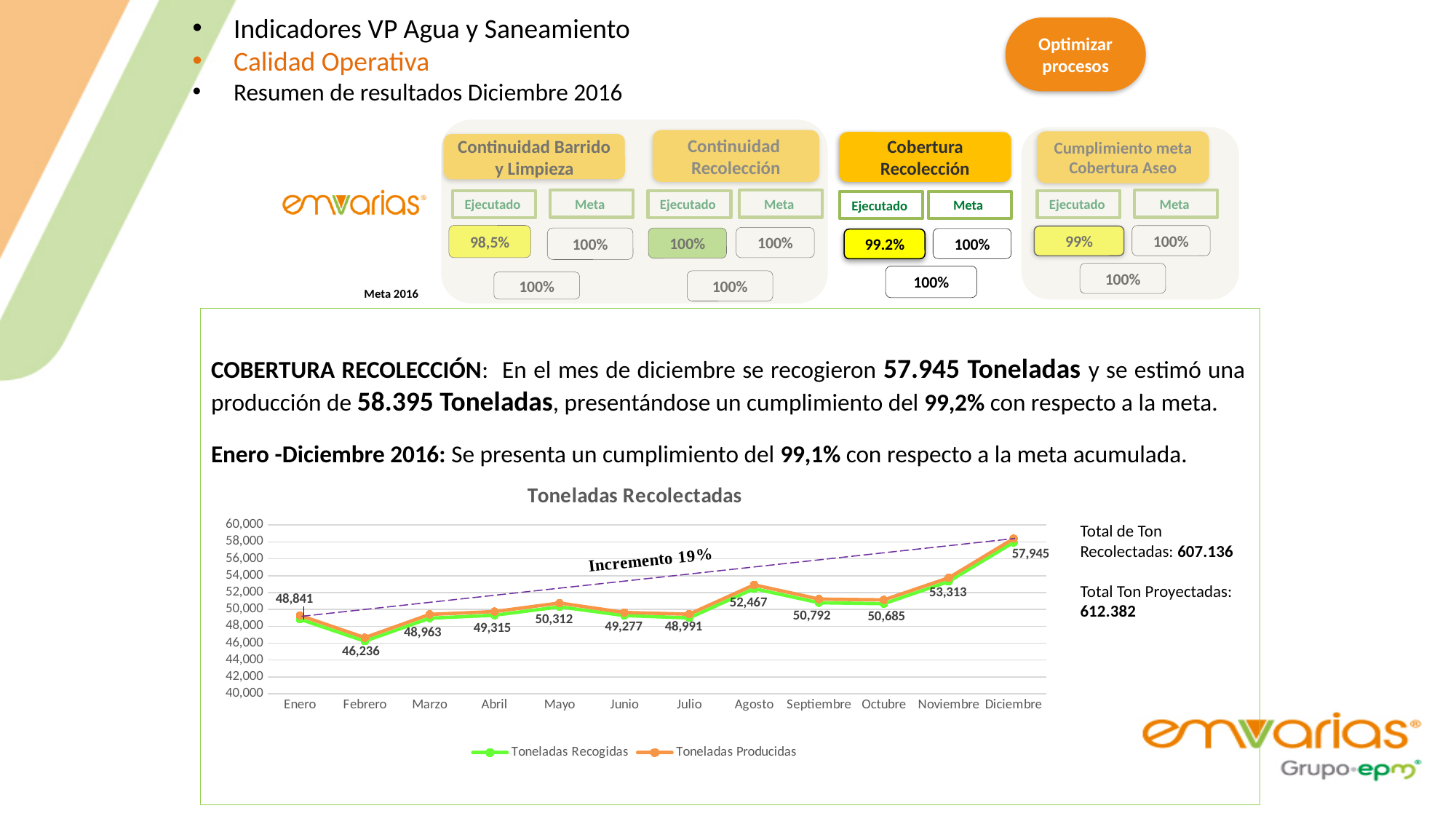
In the 'Toneladas Recolectadas' chart, what is the labelled value for Agosto? 52,467 In the 'Toneladas Recolectadas' chart, which month has the highest labelled value? Diciembre How many months are shown on the x axis of the 'Toneladas Recolectadas' chart? 12 What type of chart is 'Toneladas Recolectadas'? line chart How many series does the legend of the 'Toneladas Recolectadas' chart list? 2 In the 'Toneladas Recolectadas' chart, which month has the lowest labelled value? Febrero In the 'Toneladas Recolectadas' chart, what is the labelled value for Diciembre? 57,945 In the 'Toneladas Recolectadas' chart, is the labelled value for Noviembre greater or less than 52,000? greater In the 'Toneladas Recolectadas' chart, what is the difference between the labelled values for Diciembre and Enero? 9,104 In the 'Toneladas Recolectadas' chart, what percentage increase is annotated along the dashed trend line? Incremento 19% In the 'Toneladas Recolectadas' chart, what is the labelled value for Febrero? 46,236 In the 'Toneladas Recolectadas' chart, which is larger, the labelled value for Mayo or for Junio? Mayo